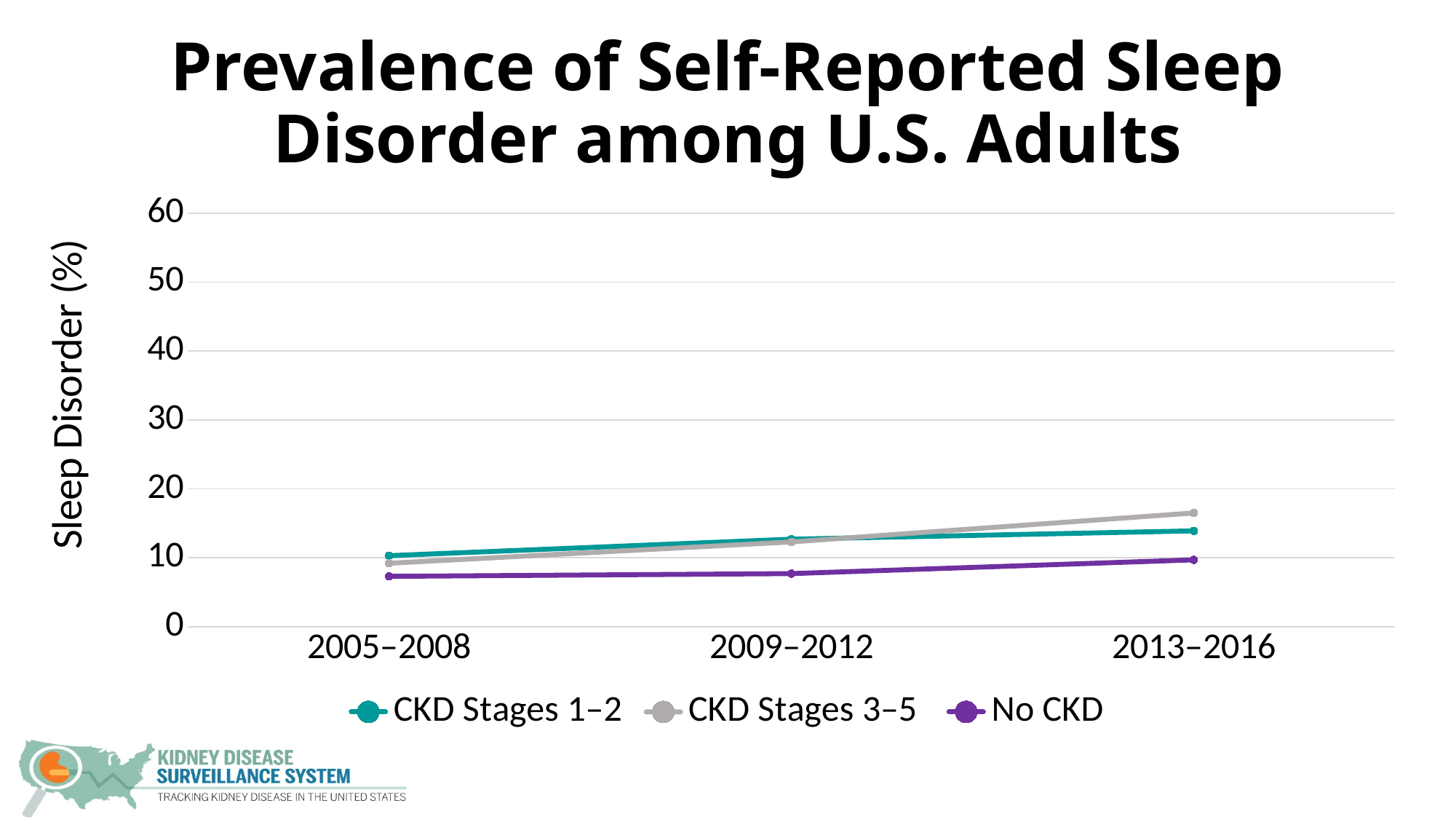
Is the value for CKD Stages 3–5 in 2013–2016 greater or less than 20? less What is the label of the y axis? Sleep Disorder (%) Which series has the highest value in 2013–2016? CKD Stages 3–5 Does the value for CKD Stages 3–5 rise or fall from 2005–2008 to 2013–2016? rise How many series does the legend list? 3 Is the value for CKD Stages 3–5 in 2013–2016 greater or less than 10? greater What kind of chart is shown on the slide? line chart Which series has the lowest value in 2013–2016? No CKD Does the value for No CKD rise or fall across the periods shown? rise In 2005–2008, which is larger: the value for CKD Stages 1–2 or the value for No CKD? CKD Stages 1–2 How many time periods are shown on the x axis? 3